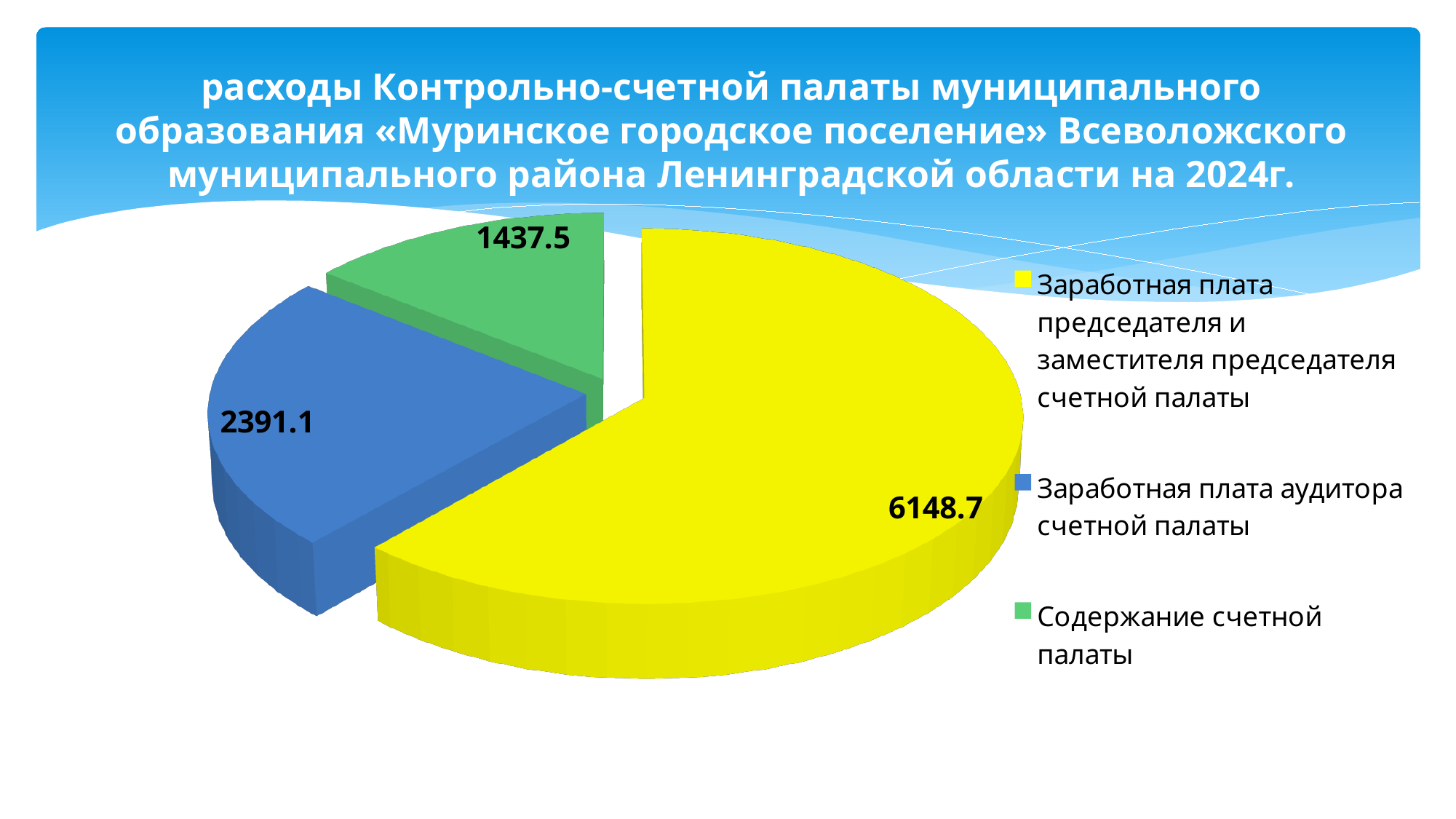
How many slices does the pie chart have? 3 What is the value of the slice for Содержание счетной палаты? 1437.5 What is the value of the slice for Заработная плата председателя и заместителя председателя счетной палаты? 6148.7 What is the total of all three slices of the pie? 9977.3 Which category has the smallest slice of the pie? Содержание счетной палаты What is the value of the slice for Заработная плата аудитора счетной палаты? 2391.1 What is the difference between the value for Заработная плата председателя и заместителя председателя счетной палаты and the value for Заработная плата аудитора счетной палаты? 3757.6 What kind of chart is shown on the slide? Pie chart What is the difference between the value for Заработная плата аудитора счетной палаты and the value for Содержание счетной палаты? 953.6 Which is larger: the value for Заработная плата аудитора счетной палаты or the value for Содержание счетной палаты? Заработная плата аудитора счетной палаты Which category has the largest slice of the pie? Заработная плата председателя и заместителя председателя счетной палаты What colour is the slice for Содержание счетной палаты? Green